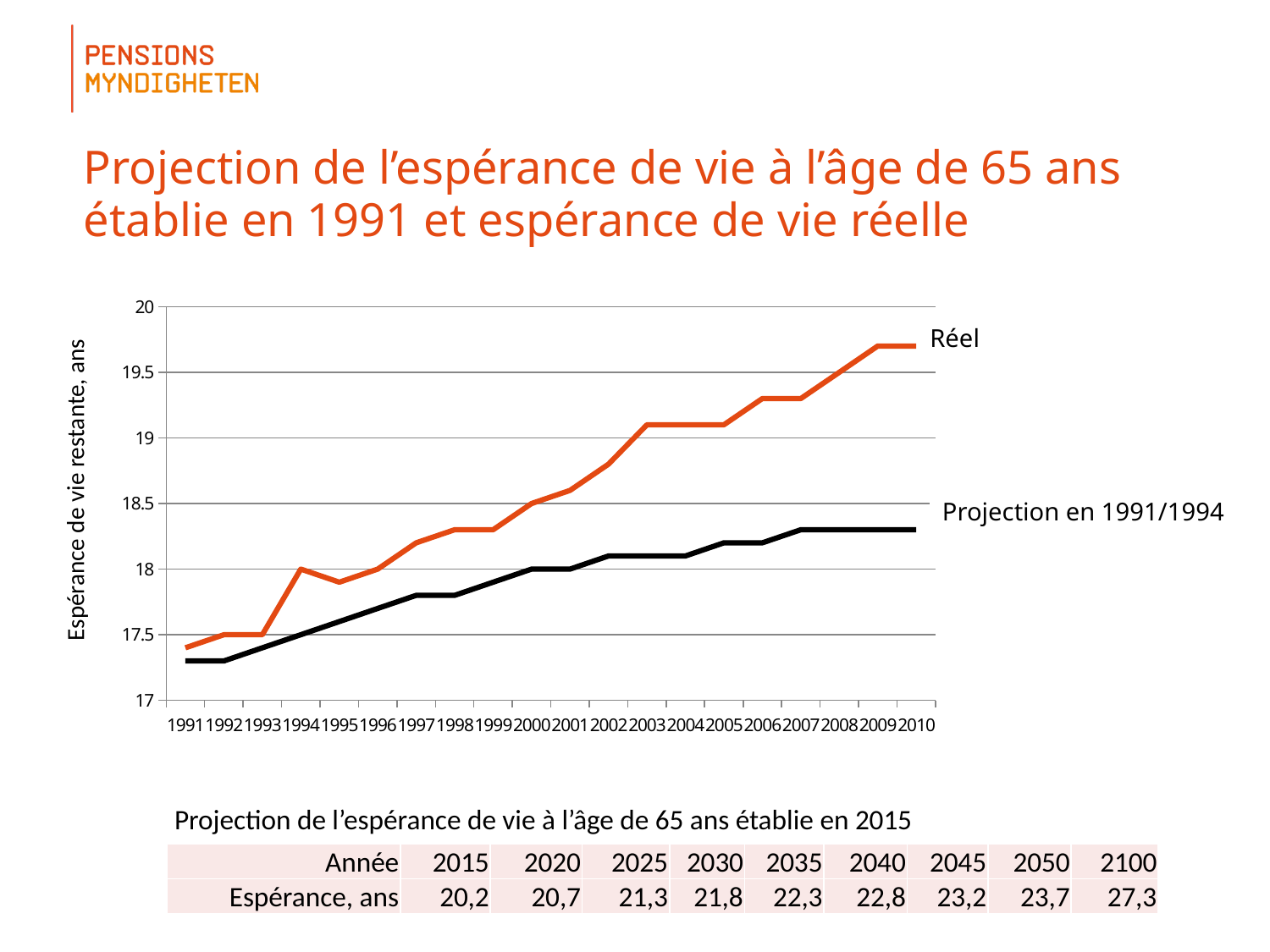
Is the Projection en 1991/1994 value for 1991 greater or less than 17.5? less Is the Projection en 1991/1994 value for 2010 greater or less than 18.5? less Does the Réel series rise or fall from 1991 to 2010? rise Is the Réel value for 2010 greater or less than 19.5? greater What is the label of the y axis of the chart? Espérance de vie restante, ans What kind of chart is shown on the slide? line chart In 2010, which series has the larger value, Réel or Projection en 1991/1994? Réel How many series are plotted on the chart? 2 What colour is the line for the Réel series? orange How many years are shown on the x axis of the chart? 20